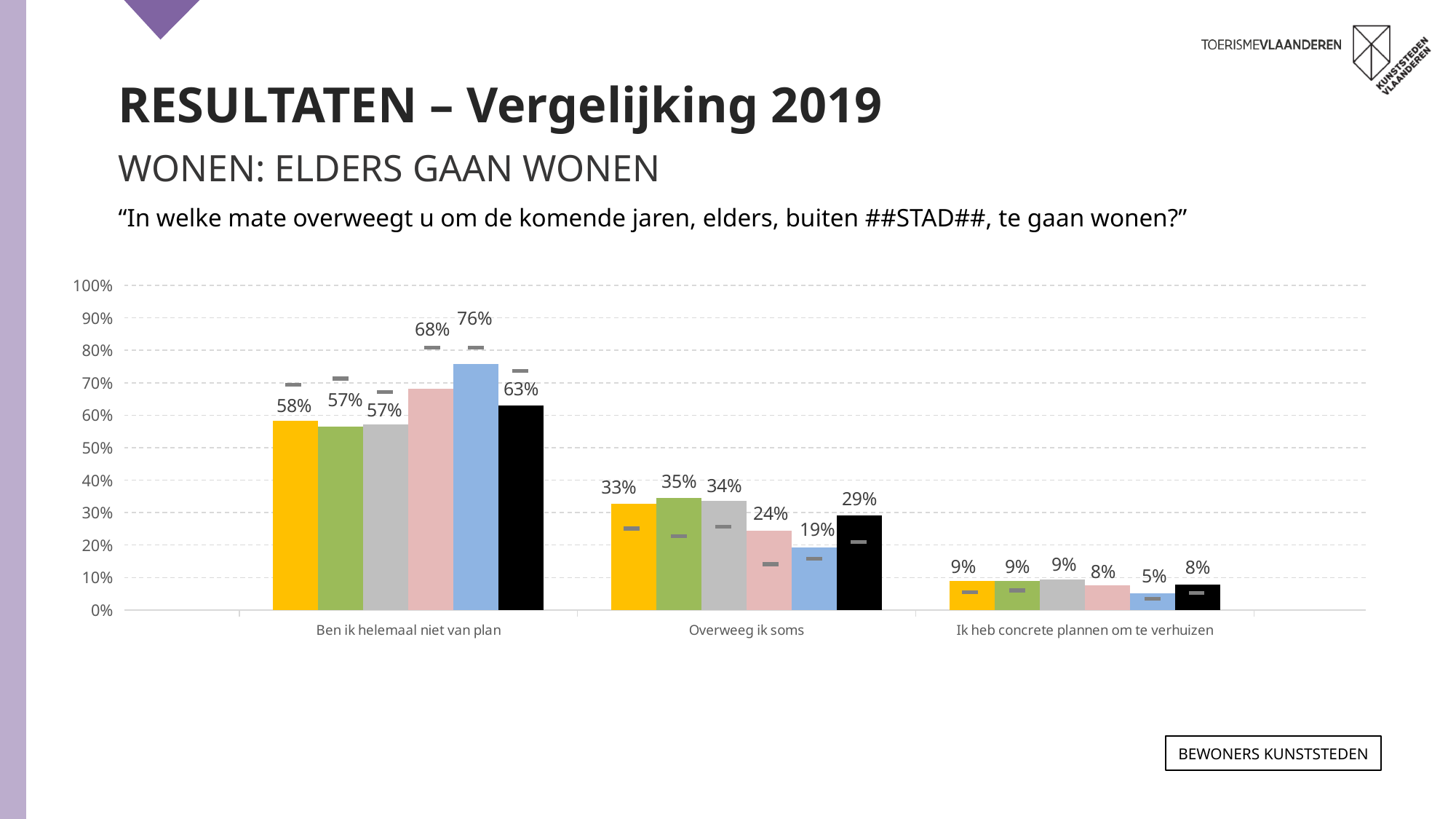
Which bar is the lowest in the 'Overweeg ik soms' category? the blue bar (19%) Which bar is the highest in the 'Ben ik helemaal niet van plan' category? the blue bar (76%) What is the value of the pink bar for 'Ben ik helemaal niet van plan'? 68% How many bars are plotted for each category in the chart? 6 What kind of chart is shown on the slide? bar chart Is the value of the black bar for 'Ben ik helemaal niet van plan' greater or less than 60%? greater For 'Overweeg ik soms', which is larger: the green bar or the pink bar? the green bar (35%) What is the value of the black bar for 'Overweeg ik soms'? 29% What is the difference between the blue bar and the yellow bar for 'Ben ik helemaal niet van plan'? 18 percentage points What is the value of the blue bar for 'Ik heb concrete plannen om te verhuizen'? 5% How many categories are shown on the x axis of the chart? 3 What is the value of the blue bar for 'Ben ik helemaal niet van plan'? 76%